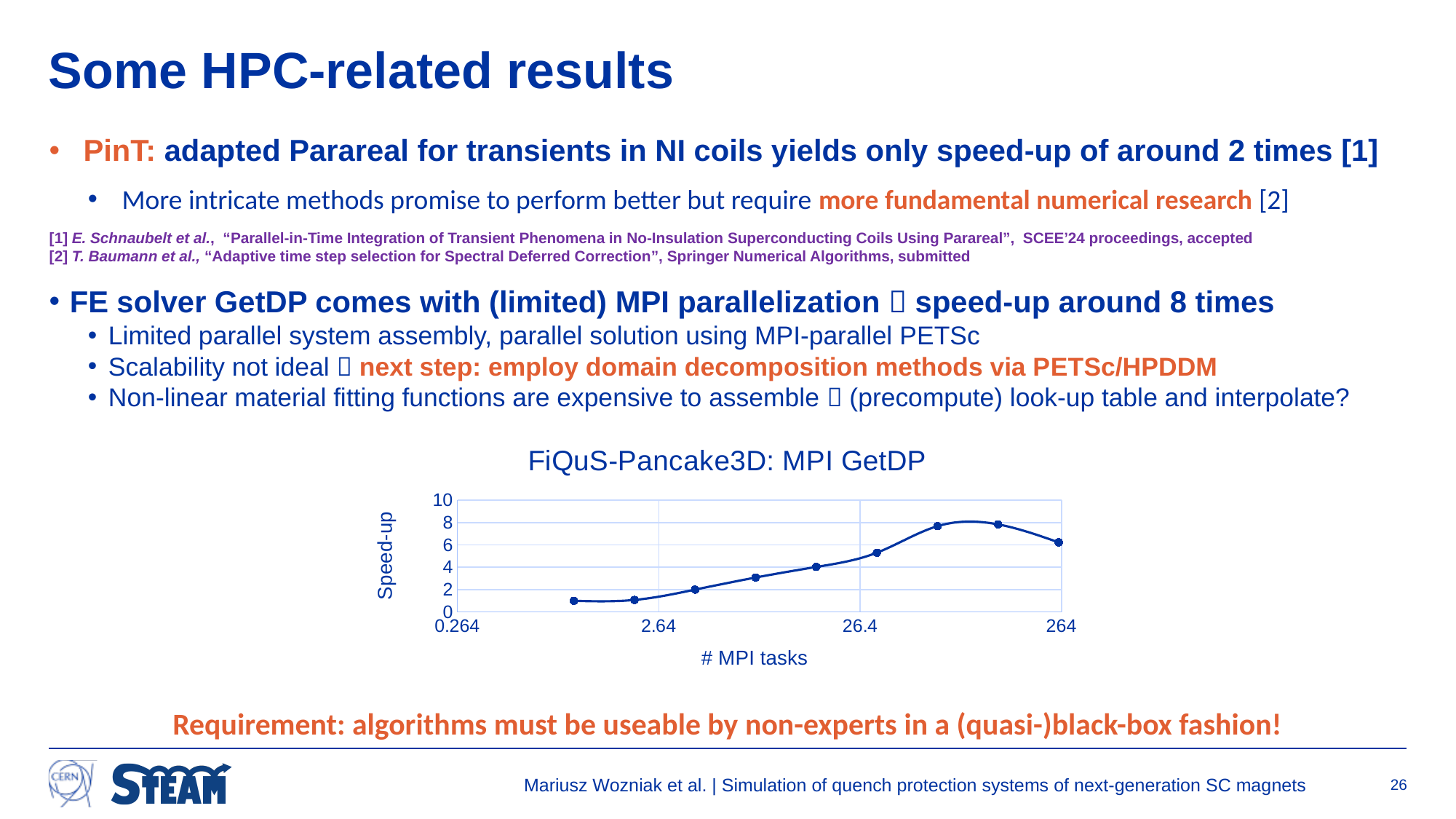
What is the label of the x axis of the chart? # MPI tasks Is the speed-up of the last (rightmost) point greater or less than 8? less Does the speed-up rise or fall from the first point to the seventh point along the x axis? rise Is the speed-up of the fifth point (near the middle of the x axis) greater or less than 6? less What kind of chart is shown on the slide? line chart How many data points are plotted on the chart? 9 Which has the larger speed-up: the first (leftmost) point or the last (rightmost) point? the last (rightmost) point Is the highest speed-up reached on the chart greater or less than 6? greater Does the speed-up rise or fall from the second-to-last point to the last point? fall What is the title of the chart? FiQuS-Pancake3D: MPI GetDP